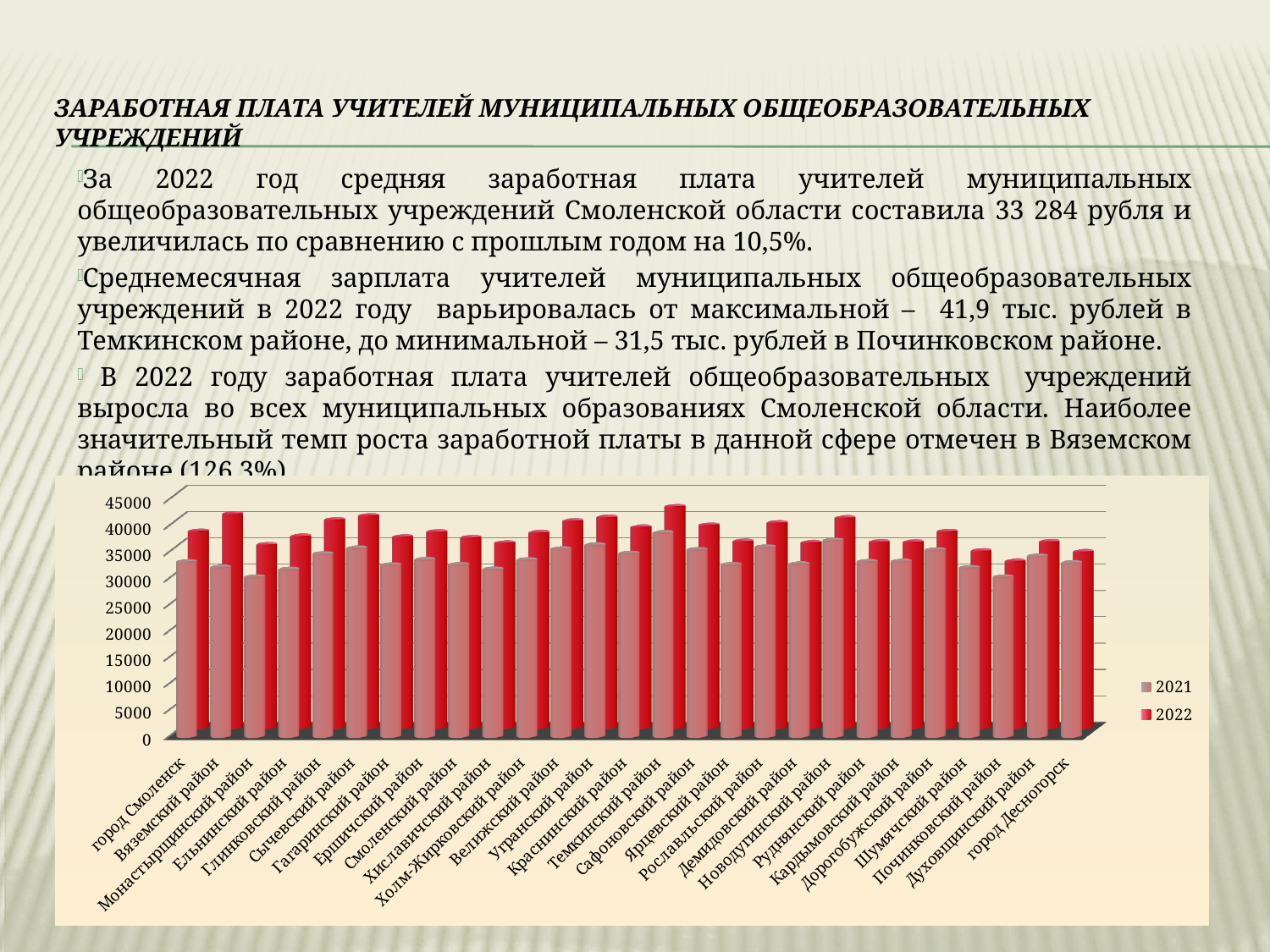
What kind of chart is shown on the slide? bar chart How many series does the chart legend list? 2 Which is larger for 2022: Темкинский район or Починковский район? Темкинский район Which years are listed in the chart legend? 2021 and 2022 Which municipality has the highest 2022 value in the chart? Темкинский район Is the 2022 value for город Смоленск greater or less than 35000? greater Which municipality has the lowest 2022 value in the chart? Починковский район Which colour represents the 2022 series in the chart? red Is the 2021 value for Ельнинский район greater or less than 35000? less Is the 2022 value for Темкинский район greater or less than 40000? greater How many municipalities (categories) are shown on the x axis of the chart? 27 For Вяземский район, which series has the larger value, 2021 or 2022? 2022